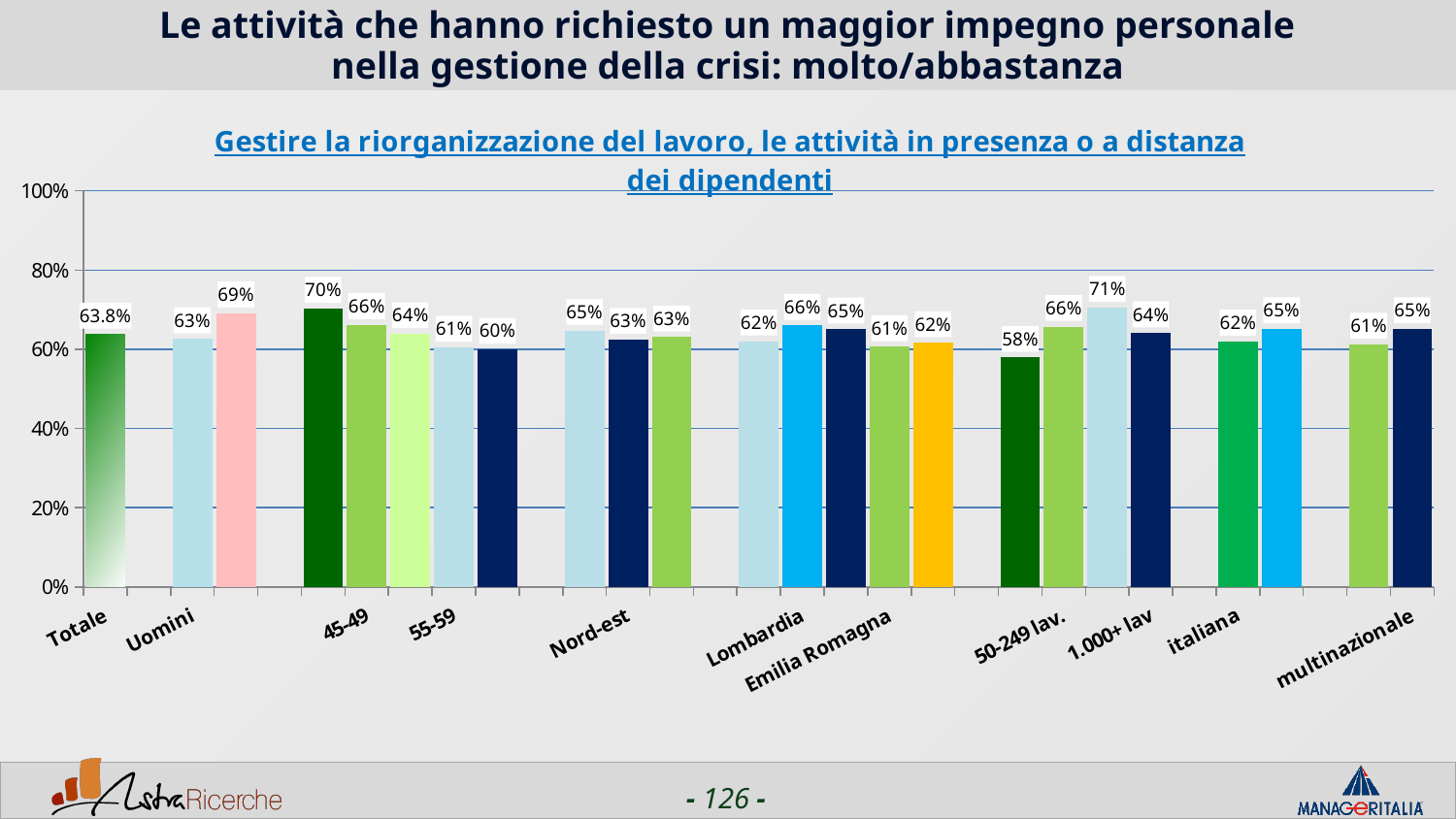
What is the value for Lombardia? 66% What is the value for Totale? 63.8% What kind of chart is shown on the slide? bar chart What is the value for Uomini? 63% What is the value for 1.000+ lav? 64% Is the value for Totale greater or less than 60%? greater What is the value for multinazionale? 65% What is the value for Emilia Romagna? 61% Which is larger, the value for 45-49 or the value for 55-59? 45-49 What is the title of the chart? Gestire la riorganizzazione del lavoro, le attività in presenza o a distanza dei dipendenti What is the difference between the values for Lombardia and Emilia Romagna? 5 percentage points